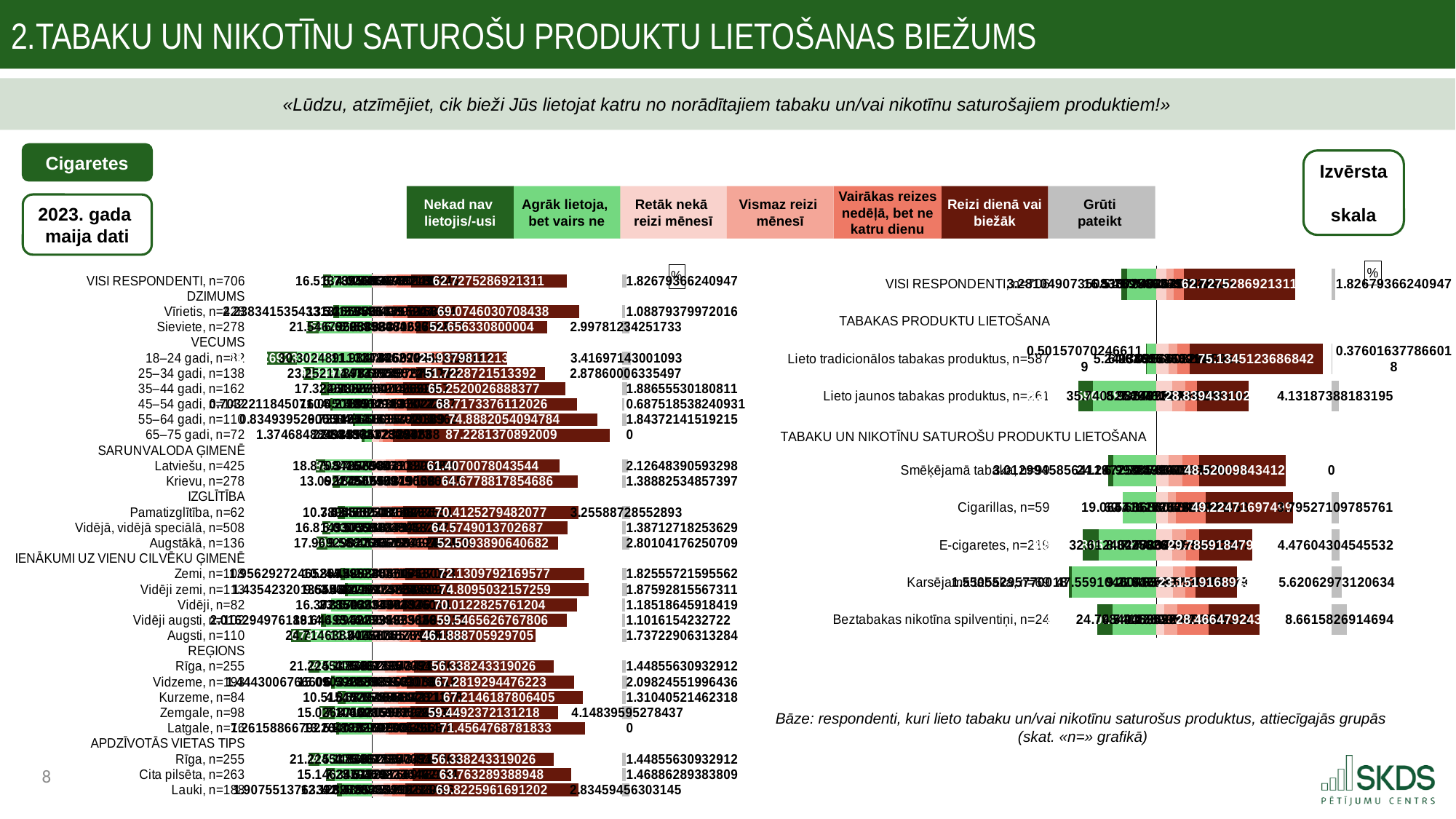
In the right chart, what is the 'Grūti pateikt' value for E-cigaretes? 4.47604304545532 In the left chart, which has the larger 'Reizi dienā vai biežāk' value: Vīrietis or Sieviete, n=278? Vīrietis In the left chart, what is the 'Reizi dienā vai biežāk' value for VISI RESPONDENTI, n=706? 62.7275286921311 In the right chart, which product group has the highest 'Grūti pateikt' value? Beztabakas nikotīna spilventiņi, n=24 What kind of chart is used on the left side of the slide (Cigaretes)? Stacked bar chart Which legend entry is shown in the darkest red colour? Reizi dienā vai biežāk In the left chart, what is the 'Grūti pateikt' value for VISI RESPONDENTI, n=706? 1.82679366240947 In the right chart, what is the 'Reizi dienā vai biežāk' value for Lieto tradicionālos tabakas produktus, n=587? 75.1345123686842 How many series does the legend list? 7 In the left chart, what is the 'Grūti pateikt' value for 65–75 gadi, n=72? 0 In the left chart, which age group has the lowest 'Reizi dienā vai biežāk' value? 18–24 gadi, n=82 In the left chart, which age group has the highest 'Reizi dienā vai biežāk' value? 65–75 gadi, n=72